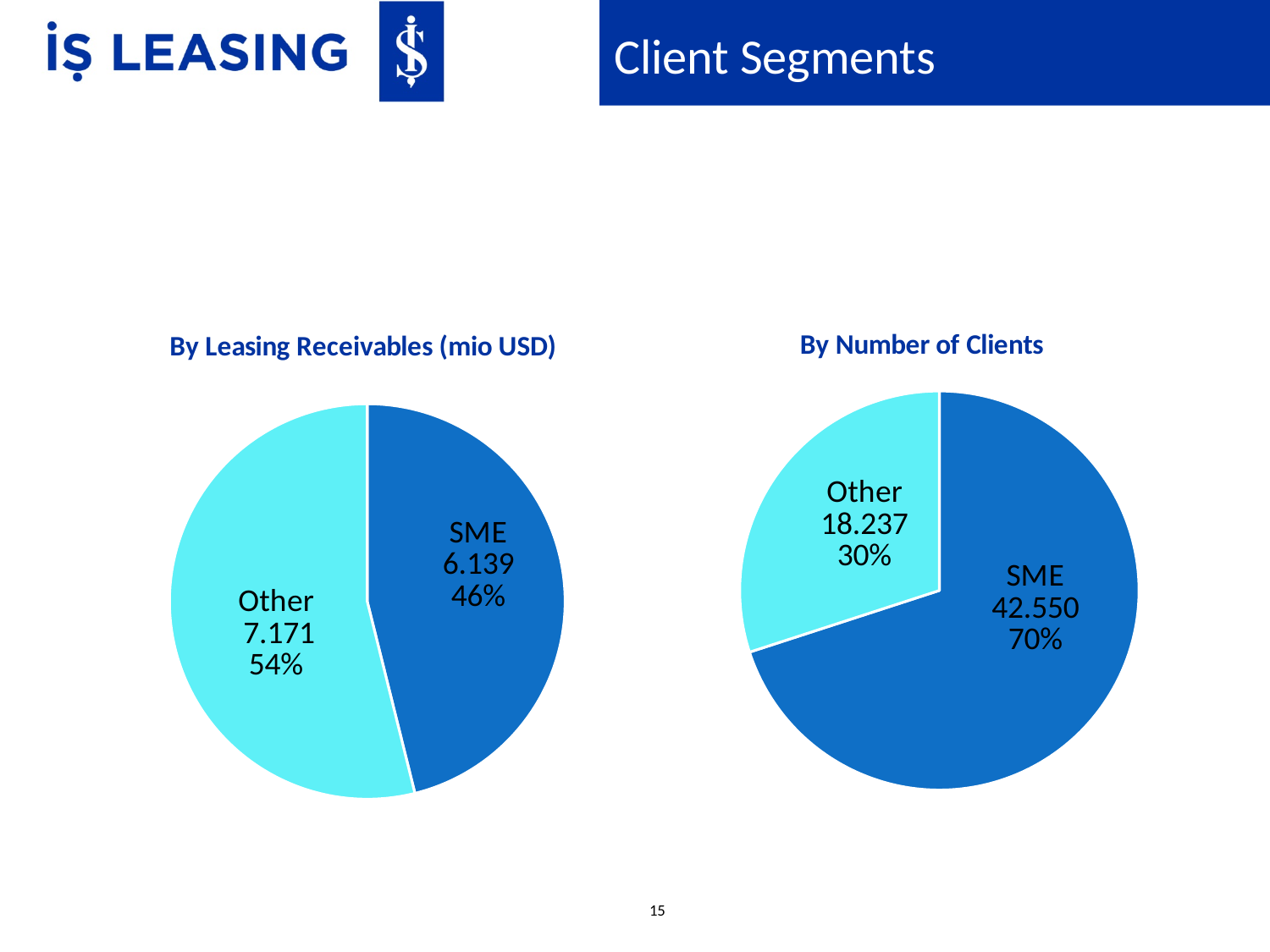
In the 'By Leasing Receivables (mio USD)' chart, which segment is the largest? Other In the 'By Number of Clients' chart, what share of the pie does SME represent? 70% In the 'By Leasing Receivables (mio USD)' chart, what is the value for Other? 7.171 In the 'By Number of Clients' chart, which segment is the smallest? Other What kind of chart is the 'By Number of Clients' chart? pie chart In the 'By Number of Clients' chart, what is the value for SME? 42.550 In the 'By Leasing Receivables (mio USD)' chart, what share of the pie does Other represent? 54% How many segments does the 'By Leasing Receivables (mio USD)' pie chart have? 2 In the 'By Number of Clients' chart, what is the value for Other? 18.237 In the 'By Leasing Receivables (mio USD)' chart, what is the value for SME? 6.139 What is the title of the chart on the right side of the slide? By Number of Clients In the 'By Number of Clients' chart, is the value for SME larger or smaller than the value for Other? larger